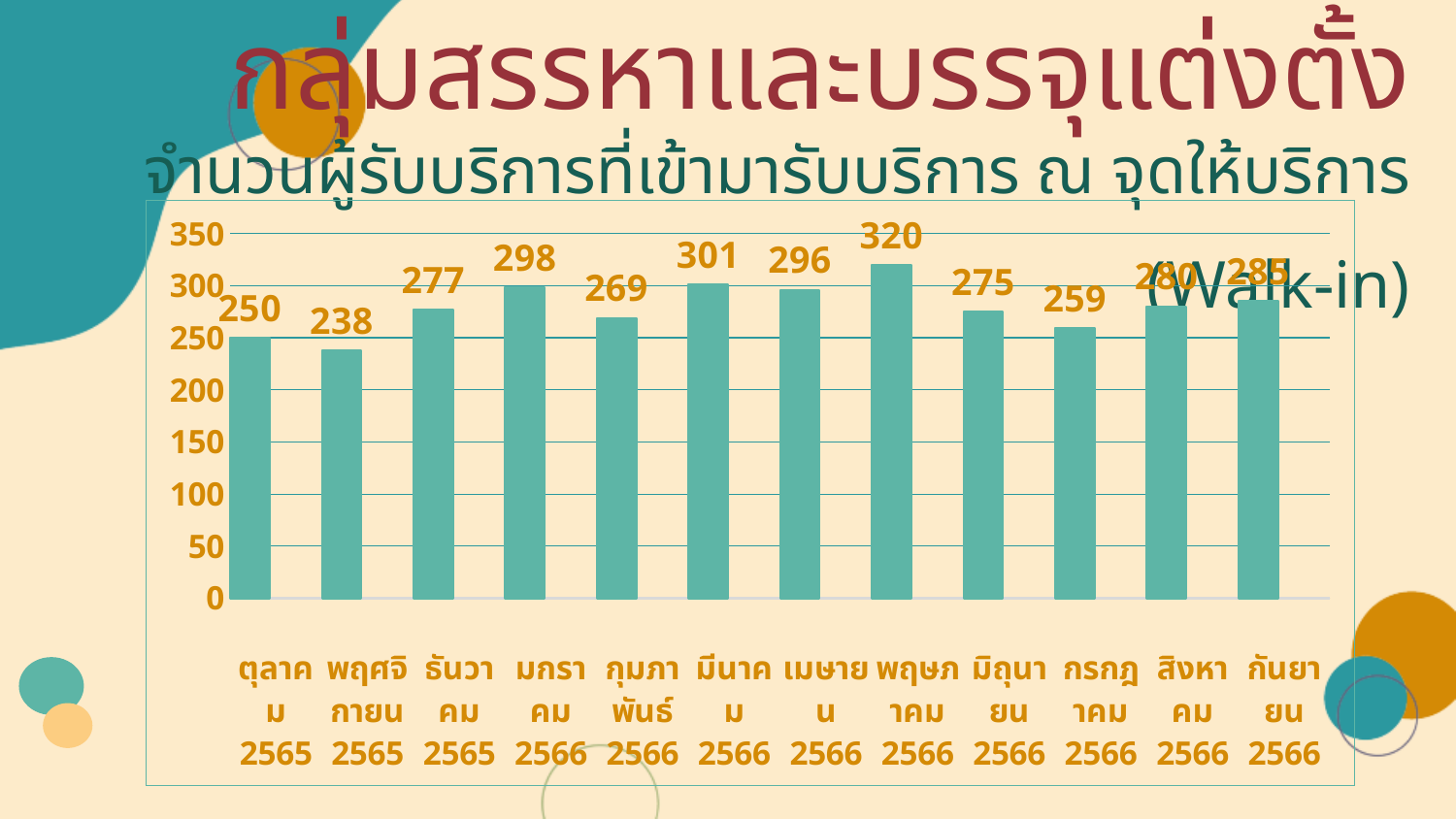
What kind of chart is shown on the slide? bar chart Is the value for เมษายน 2566 greater or less than 250? greater What is the value for มีนาคม 2566? 301 How many months are shown on the x axis? 12 What is the value for กุมภาพันธ์ 2566? 269 Which is larger, the value for มิถุนายน 2566 or the value for กรกฎาคม 2566? มิถุนายน 2566 What is the difference between the values for มกราคม 2566 and ธันวาคม 2565? 21 Which month has the highest value? พฤษภาคม 2566 What is the title of the chart? จำนวนผู้รับบริการที่เข้ามารับบริการ ณ จุดให้บริการ (Walk-in) Which month has the lowest value? พฤศจิกายน 2565 What is the value for ตุลาคม 2565? 250 What is the difference between the values for พฤษภาคม 2566 and พฤศจิกายน 2565? 82